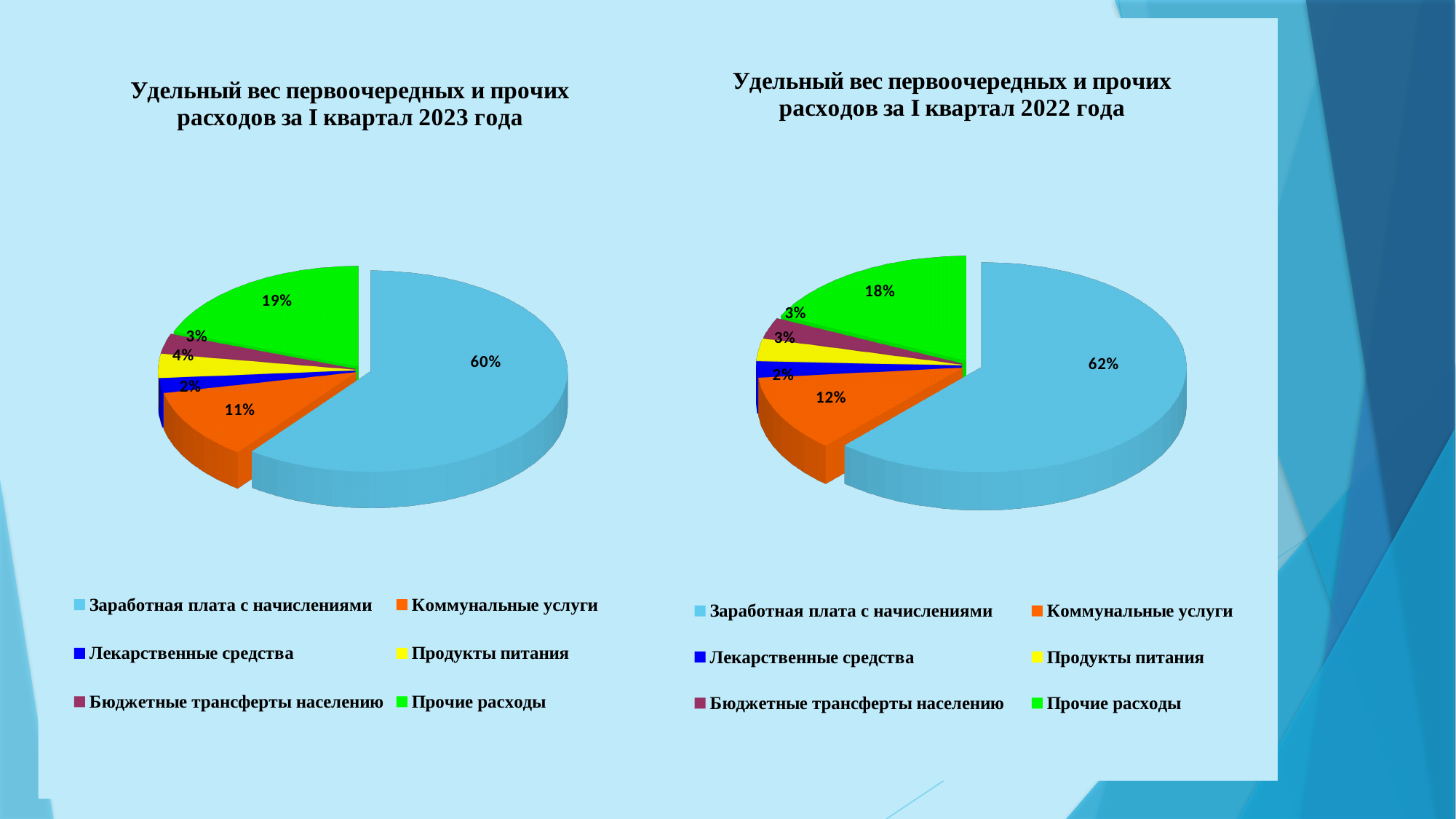
In the chart for I квартал 2022 года (right), what colour represents Прочие расходы? Green In the chart for I квартал 2022 года (right), what share is Заработная плата с начислениями? 62% In the chart for I квартал 2023 года (left), which category has the largest share? Заработная плата с начислениями Which is larger: the share of Коммунальные услуги in the 2023 chart (left) or in the 2022 chart (right)? 2022 chart (right) How many categories does the legend of the chart for I квартал 2022 года (right) list? 6 In the chart for I квартал 2022 года (right), which category has the smallest share? Лекарственные средства In the chart for I квартал 2023 года (left), what share is Прочие расходы? 19% In the chart for I квартал 2023 года (left), what is the difference between the shares of Прочие расходы and Коммунальные услуги? 8% In the chart for I квартал 2023 года (left), what share is Продукты питания? 4% What type of chart is used on the left for I квартал 2023 года? Pie chart